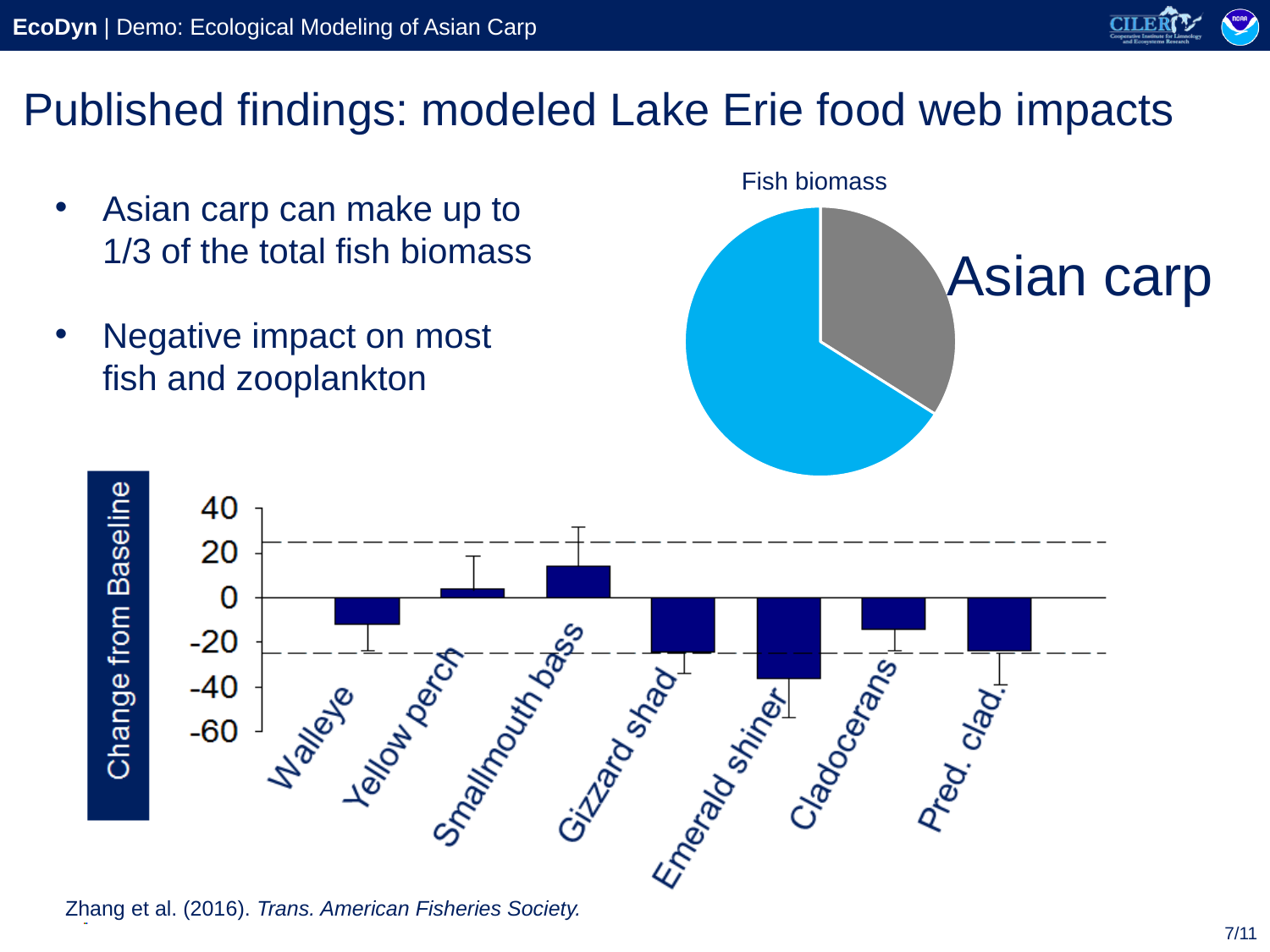
In the 'Change from Baseline' bar chart, which is larger, the value for Walleye or the value for Emerald shiner? Walleye In the 'Change from Baseline' bar chart, which category has the lowest value? Emerald shiner In the 'Change from Baseline' bar chart, which is larger, the value for Smallmouth bass or the value for Yellow perch? Smallmouth bass In the 'Change from Baseline' bar chart, is the value for Emerald shiner greater or less than -20? less In the 'Fish biomass' pie chart, what is the label of the gray slice? Asian carp What kind of chart is the lower chart labeled 'Change from Baseline'? bar chart In the 'Change from Baseline' bar chart, is the value for Smallmouth bass greater or less than 0? greater In the 'Change from Baseline' bar chart, which category has the highest value? Smallmouth bass What kind of chart is the 'Fish biomass' chart? pie chart In the 'Change from Baseline' bar chart, is the value for Walleye greater or less than 0? less In the 'Change from Baseline' bar chart, how many categories are shown on the x axis? 7 In the 'Fish biomass' pie chart, how many slices are there? 2